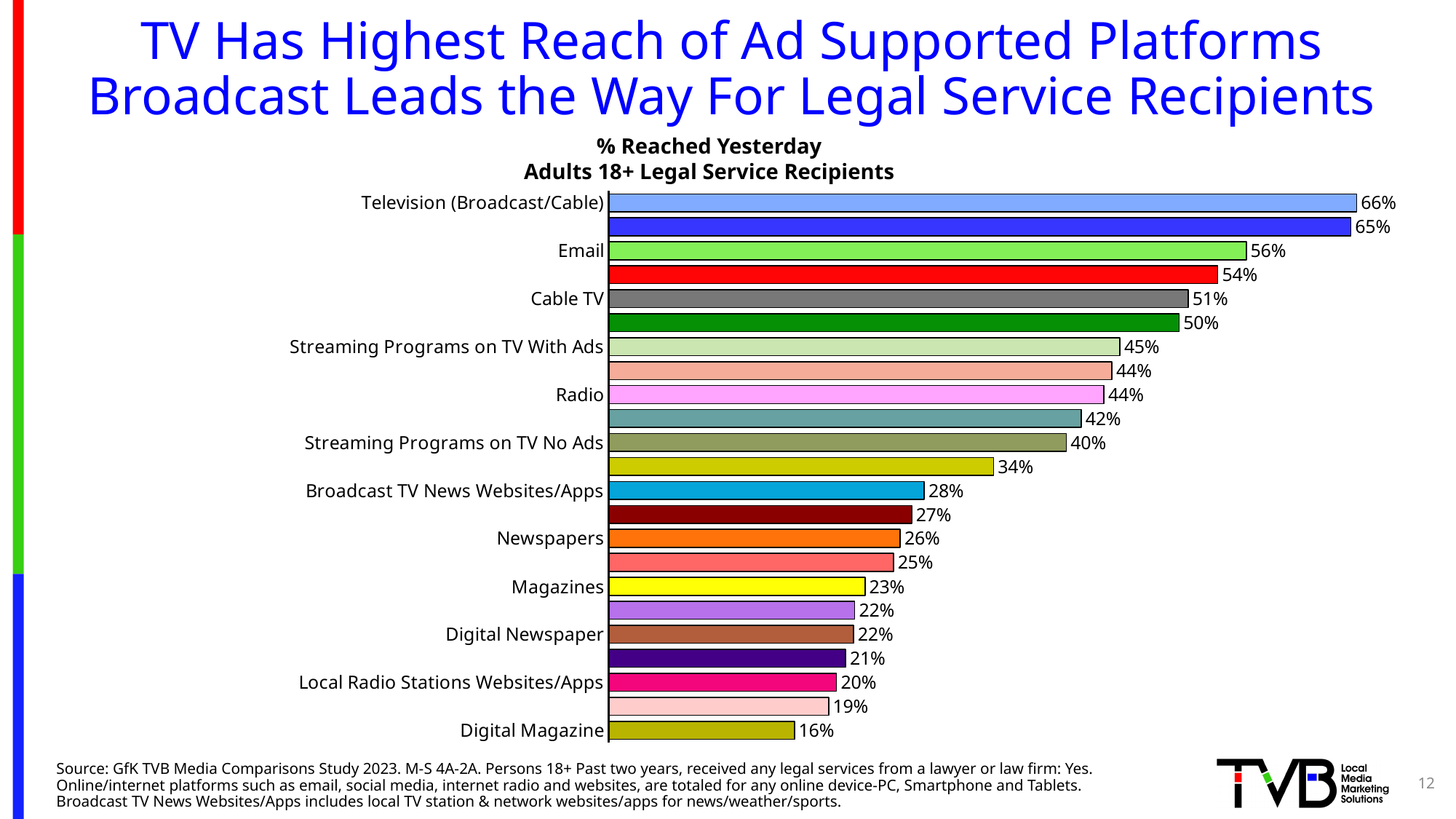
What is the value for Digital Magazine? 16% Which labeled category has the highest value? Television (Broadcast/Cable) What kind of chart is shown on the slide? Bar chart Which labeled category has the lowest value? Digital Magazine What is the subtitle printed above the chart? % Reached Yesterday Adults 18+ Legal Service Recipients Which is larger, the value for Newspapers or the value for Magazines? Newspapers What is the value for Email? 56% What is the value for Television (Broadcast/Cable)? 66% What is the difference between the values for Television (Broadcast/Cable) and Email? 10% What is the value for Radio? 44% What is the value for Cable TV? 51% What is the difference between the values for Streaming Programs on TV With Ads and Streaming Programs on TV No Ads? 5%